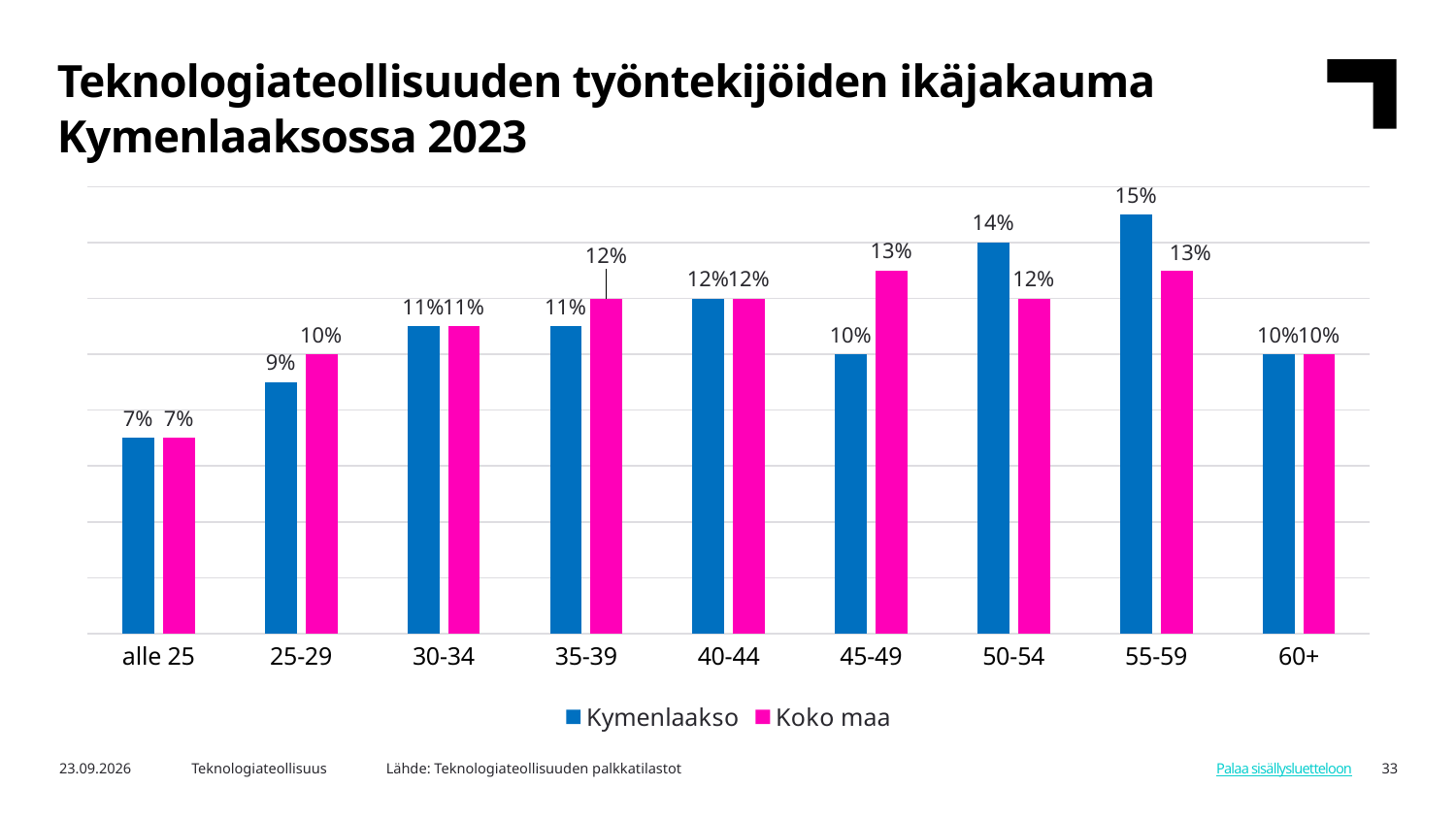
What is the Koko maa value for the 45-49 age group? 13% How many age groups are shown on the x axis? 9 Which is larger for the 50-54 age group, Kymenlaakso or Koko maa? Kymenlaakso Which colour represents the Koko maa series? Pink What kind of chart is shown on the slide? Bar chart Which is larger for the 35-39 age group, Kymenlaakso or Koko maa? Koko maa Which age group has the highest Kymenlaakso value? 55-59 What is the Kymenlaakso value for the 55-59 age group? 15% How many series does the legend list? 2 What is the Kymenlaakso value for the 25-29 age group? 9% What is the difference between the Kymenlaakso and Koko maa values for the 45-49 age group? 3% Which age group has the lowest Koko maa value? alle 25